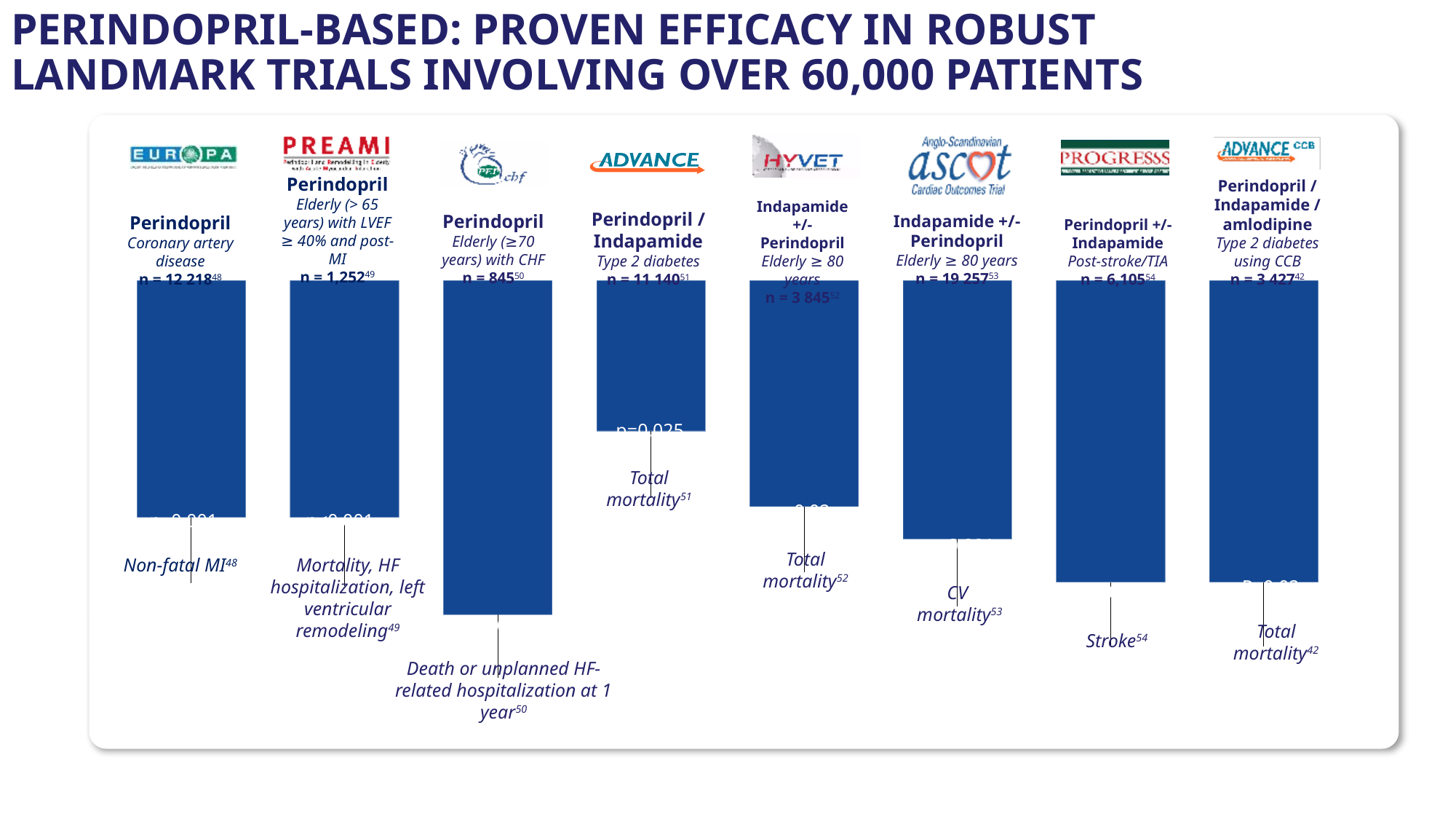
What outcome is labelled under the PROGRESS bar? Stroke How many bars (trials) are plotted in the chart? 8 Which bar extends further down, PEP-CHF or ADVANCE? PEP-CHF What kind of chart is shown on the slide? Bar chart Which trial has the longest bar in the chart? PEP-CHF Which bar extends further down, PROGRESS or EUROPA? PROGRESS What is the number of patients (n) shown for the ASCOT trial? n = 19 257 Which bar extends further down, ADVANCE CCB or HYVET? ADVANCE CCB Which trial has the shortest bar in the chart? ADVANCE